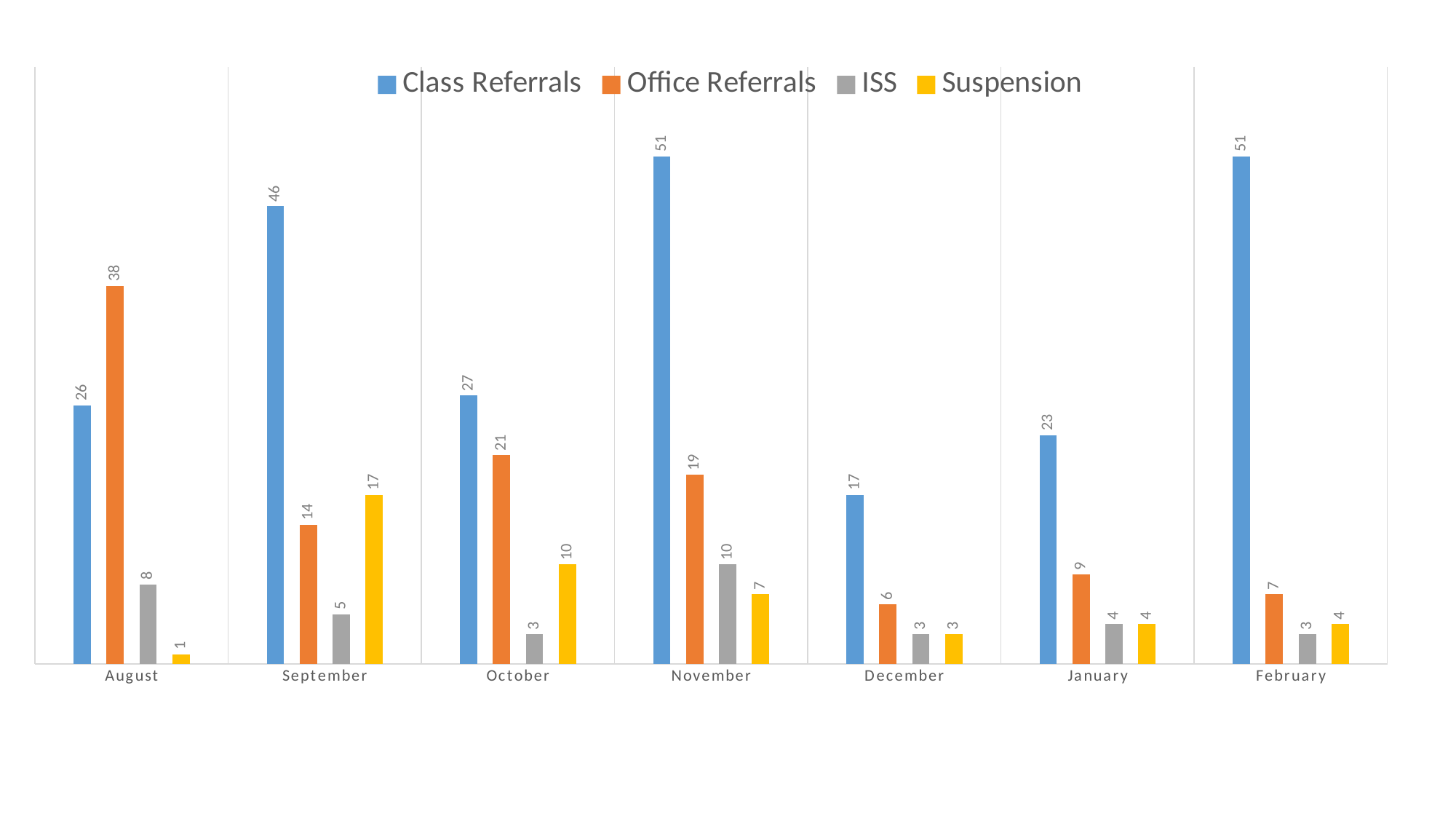
Which month has the highest value for Office Referrals? August What kind of chart is shown on the slide? Bar chart Which month has the lowest value for Class Referrals? December What is the value of Class Referrals for September? 46 How many series does the legend list? 4 What is the value of Suspension for October? 10 What is the value of Office Referrals for August? 38 How many months are shown on the x axis? 7 Which colour represents Suspension in the legend? Yellow What is the difference between Class Referrals and Office Referrals in November? 32 Which is larger in August: Class Referrals or Office Referrals? Office Referrals What is the value of ISS for November? 10